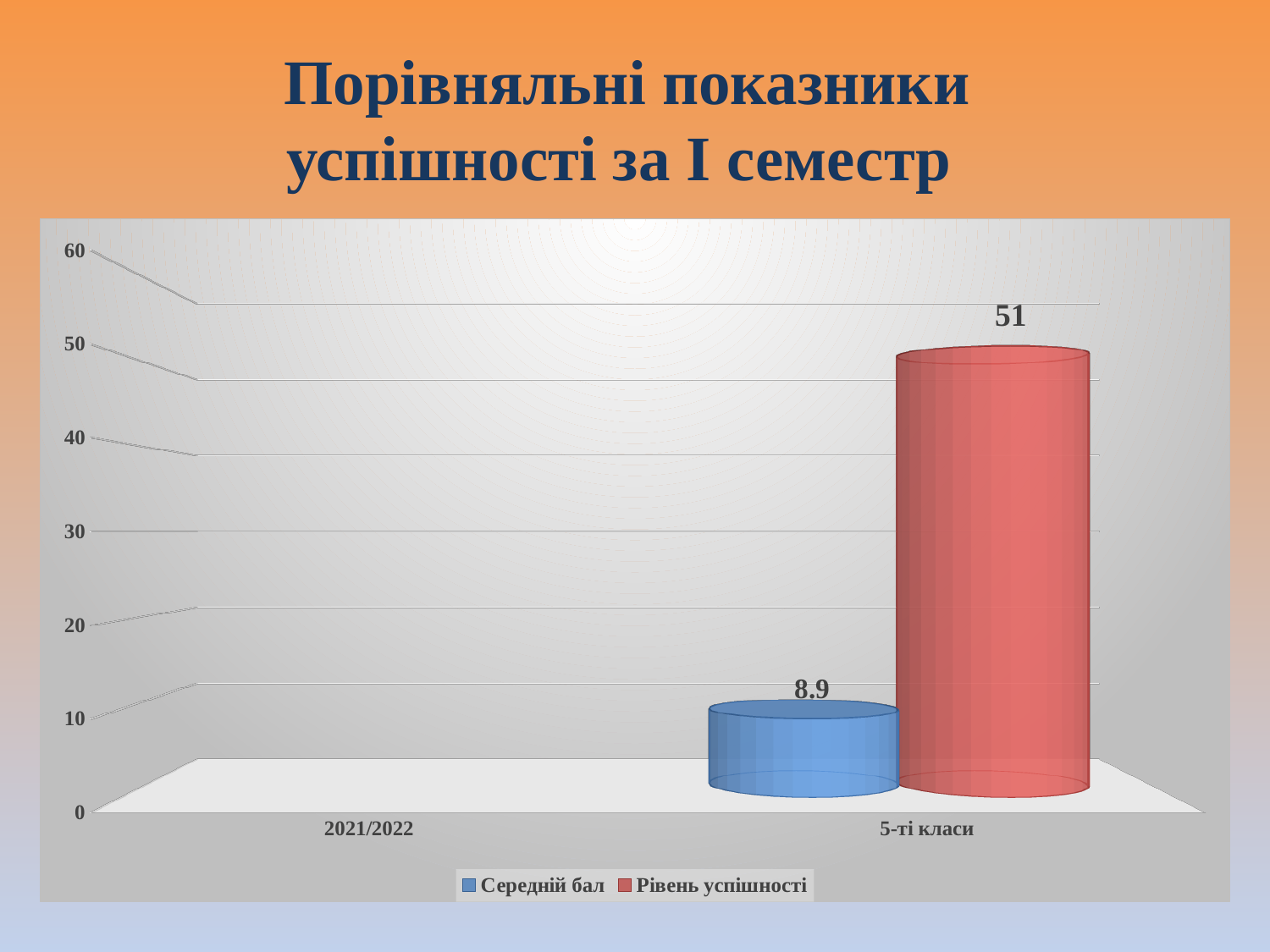
How many categories are shown on the x axis? 2 What is the value of Середній бал for 5-ті класи? 8.9 What is the title of the slide? Порівняльні показники успішності за І семестр What is the highest value shown on the vertical axis? 60 Is the value of Рівень успішності for 5-ті класи greater or less than 40? greater What is the difference between Рівень успішності and Середній бал for 5-ті класи? 42.1 Is the value of Середній бал for 5-ті класи greater or less than 10? less What is the value of Рівень успішності for 5-ті класи? 51 Which series has the higher value for 5-ті класи, Середній бал or Рівень успішності? Рівень успішності Which colour represents the Рівень успішності series? red What kind of chart is shown on the slide? bar chart How many series does the legend list? 2